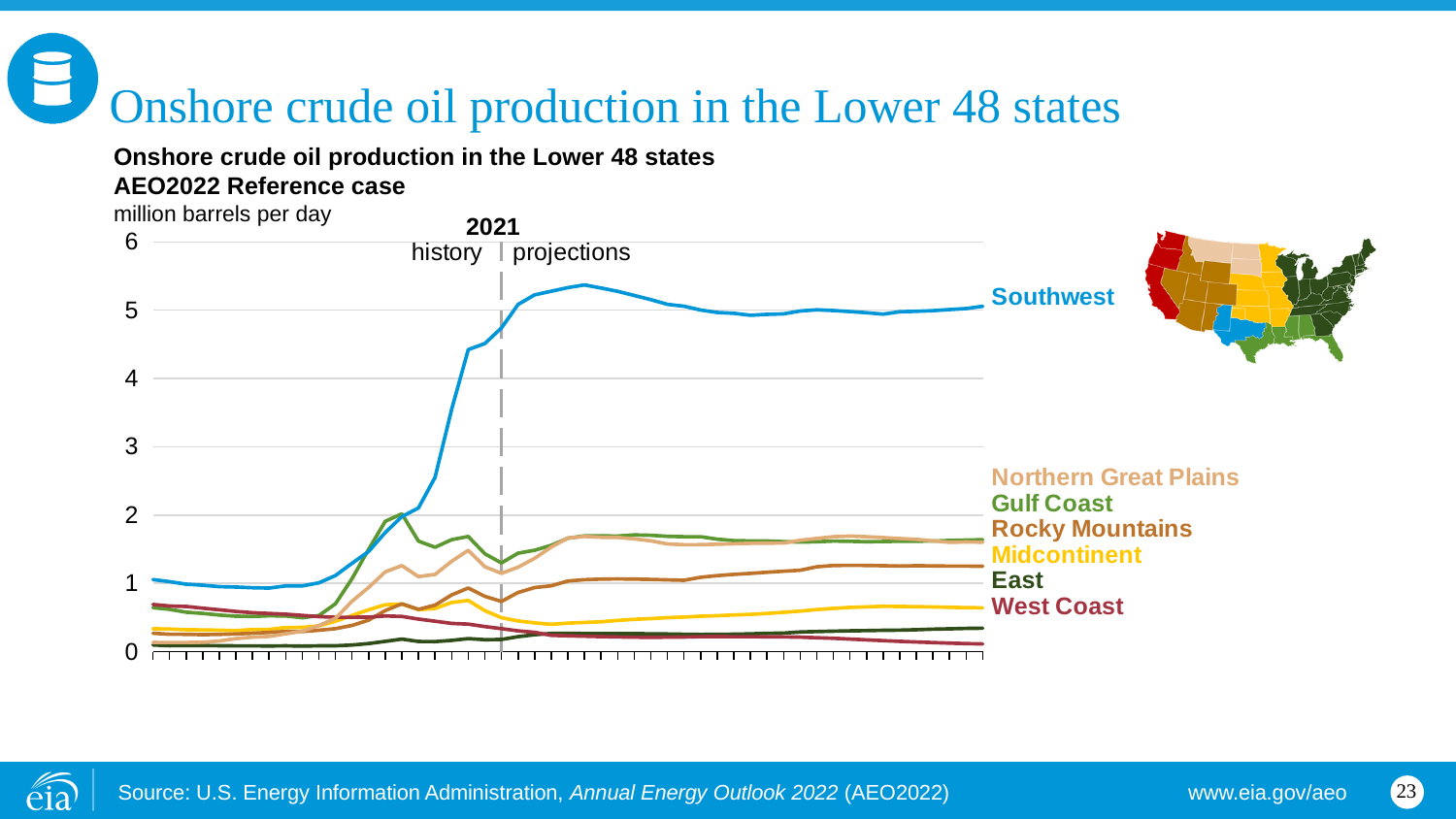
What unit is used on the chart's vertical axis? million barrels per day Is the value for the Southwest at the 2021 dividing line greater or less than 4 million barrels per day? greater At the end of the projection period, which is larger: Southwest production or Gulf Coast production? Southwest Which region has the lowest onshore crude oil production at the end of the projection period? West Coast How many regions (series) are labeled on the chart? 7 Does West Coast production rise or fall over the projection period? fall What kind of chart is shown on the slide? line chart Is the value for the West Coast at the end of the projection period greater or less than 1 million barrels per day? less Which region has the highest onshore crude oil production at the end of the projection period? Southwest Is the peak value for the Southwest during the projection period greater or less than 5 million barrels per day? greater Does Southwest production rise or fall over the history period shown? rise